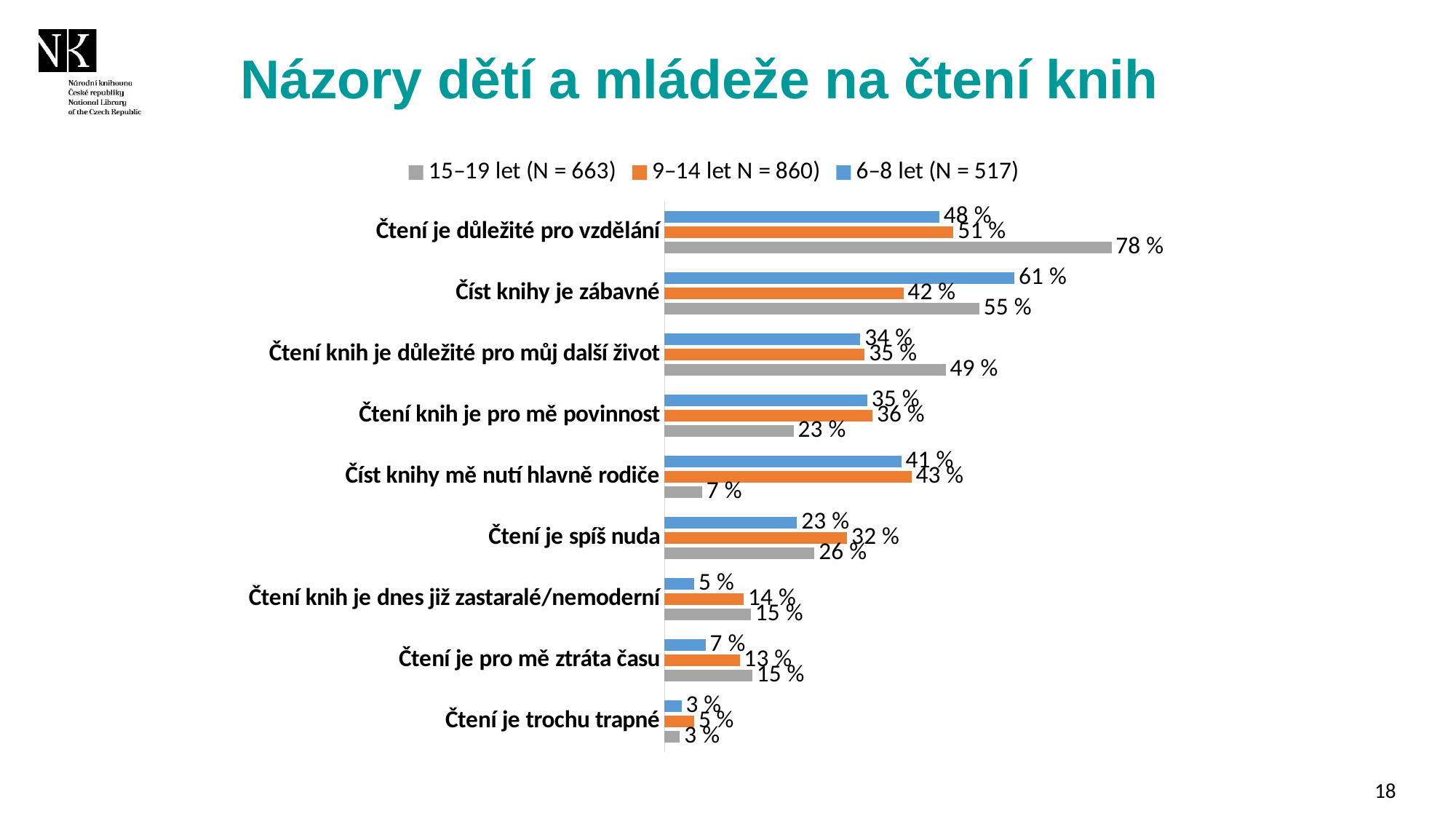
What is the value for the 9–14 let group for "Čtení je spíš nuda"? 32 % For "Čtení knih je pro mě povinnost", which group has the larger value: 9–14 let or 15–19 let? 9–14 let Which statement has the lowest value for the 6–8 let group? Čtení je trochu trapné What is the difference between the 9–14 let and 15–19 let values for "Číst knihy mě nutí hlavně rodiče"? 36 % Which series is shown in orange in the legend? 9–14 let N = 860) What type of chart is shown on the slide? bar chart Which statement has the highest value for the 15–19 let group? Čtení je důležité pro vzdělání How many series does the legend list? 3 What is the value for the 15–19 let group for "Čtení je důležité pro vzdělání"? 78 % What is the difference between the 15–19 let and 6–8 let values for "Čtení knih je důležité pro můj další život"? 15 % How many statements (categories) are shown in the chart? 9 What is the value for the 6–8 let group for "Číst knihy je zábavné"? 61 %